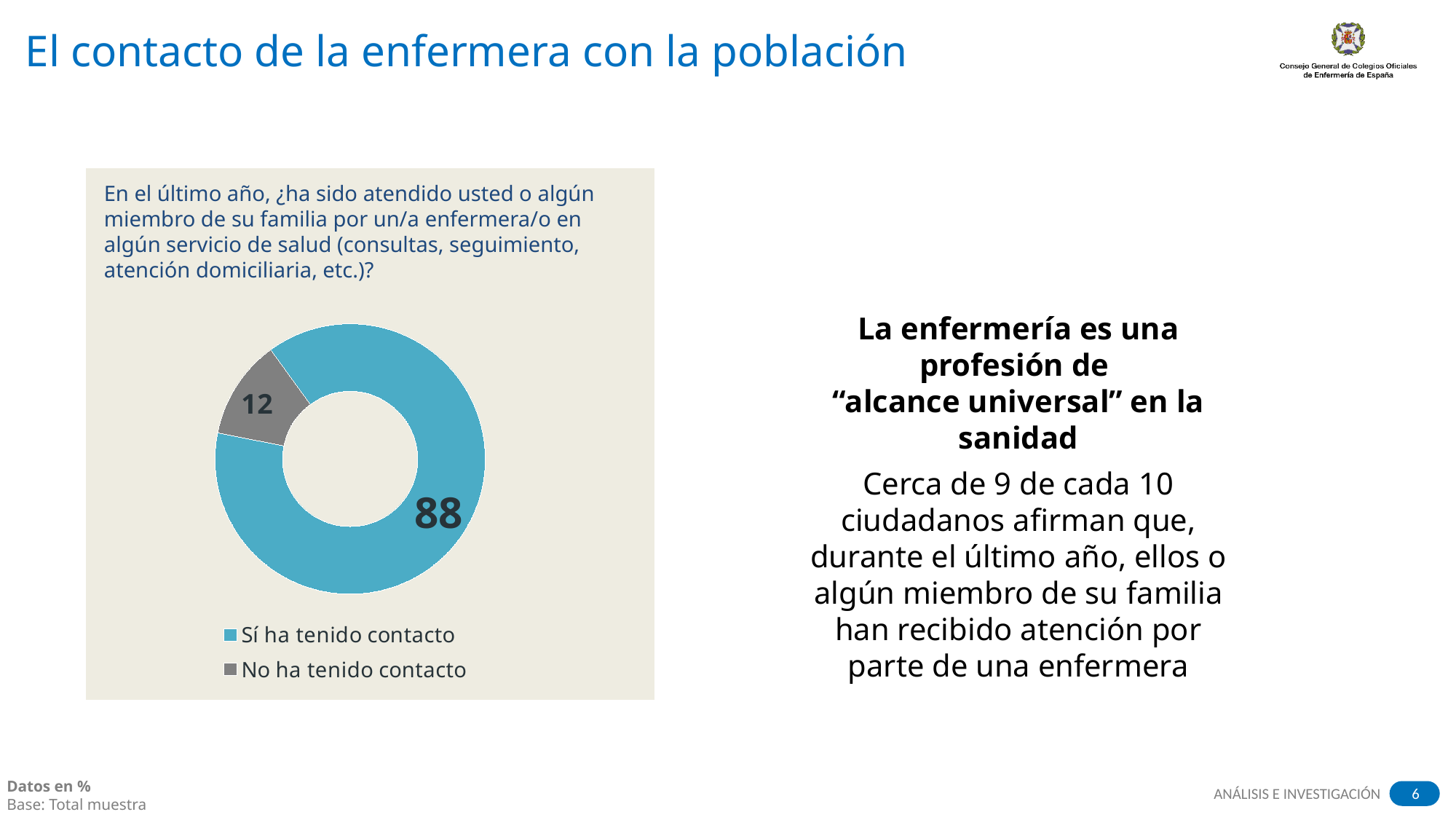
What is the difference between the values for "Sí ha tenido contacto" and "No ha tenido contacto"? 76 Which category has the largest share of the chart? Sí ha tenido contacto What share of the chart does "No ha tenido contacto" represent? 12% How many entries does the legend list? 2 Which is larger: "Sí ha tenido contacto" or "No ha tenido contacto"? Sí ha tenido contacto Which category has the smallest share of the chart? No ha tenido contacto What value is shown for "Sí ha tenido contacto"? 88 What kind of chart is shown on the slide? Doughnut chart What value is shown for "No ha tenido contacto"? 12 How many categories does the chart show? 2 What colour is the "No ha tenido contacto" segment? Grey What colour is the "Sí ha tenido contacto" segment? Blue